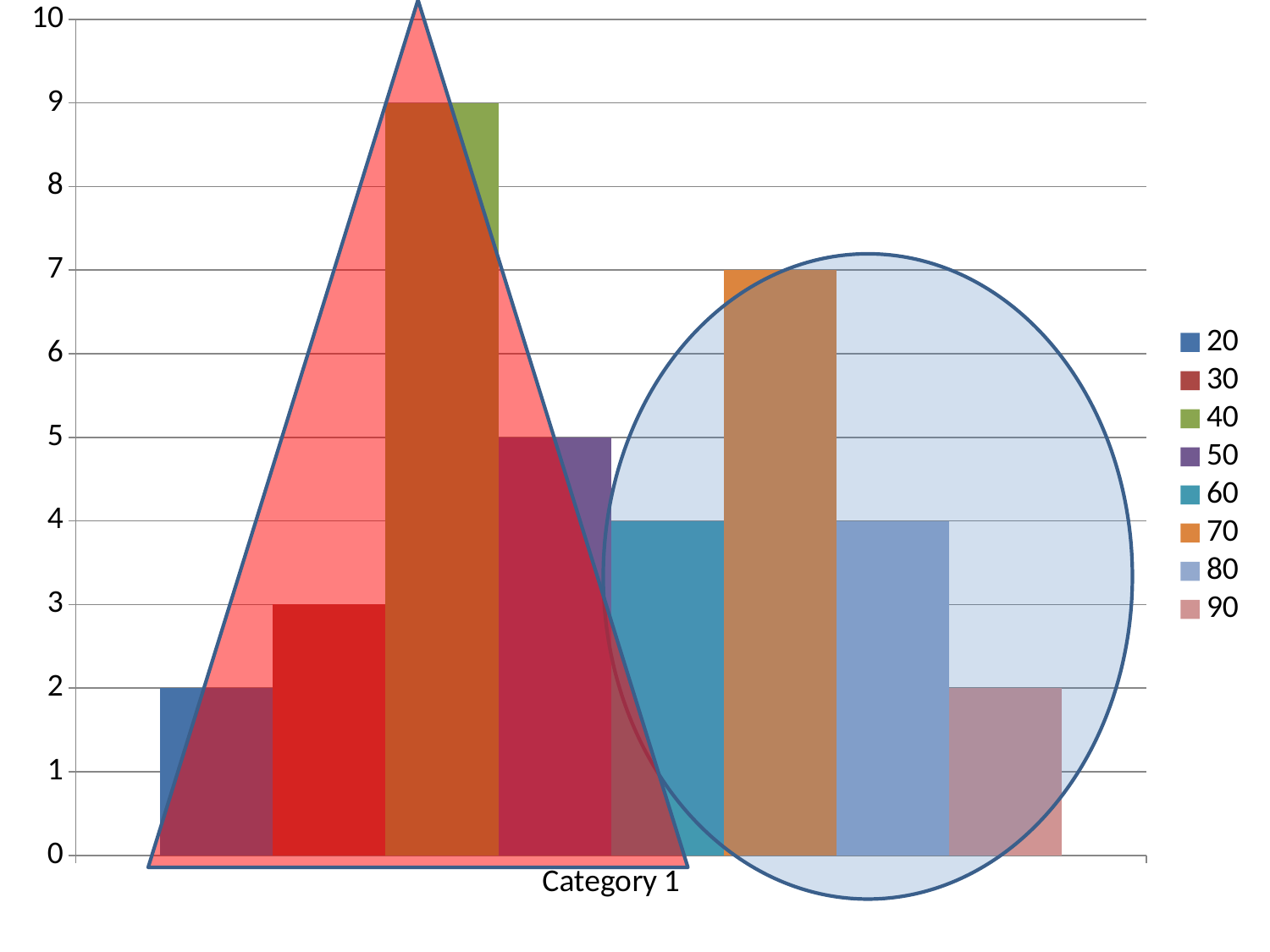
Is the value for series 50 greater or less than 4? greater Which is larger, the value of series 70 or the value of series 60? 70 Which series has the highest value for Category 1? 40 What two shapes are drawn over the chart? a triangle and an oval How many series does the legend list? 8 What is the value of series 40 for Category 1? 9 What is the difference between the values of series 40 and series 50? 4 What type of chart is shown on the slide? bar chart What is the value of series 70 for Category 1? 7 How many categories are shown on the x axis? 1 What is the value of series 30 for Category 1? 3 What is the label of the category on the x axis? Category 1